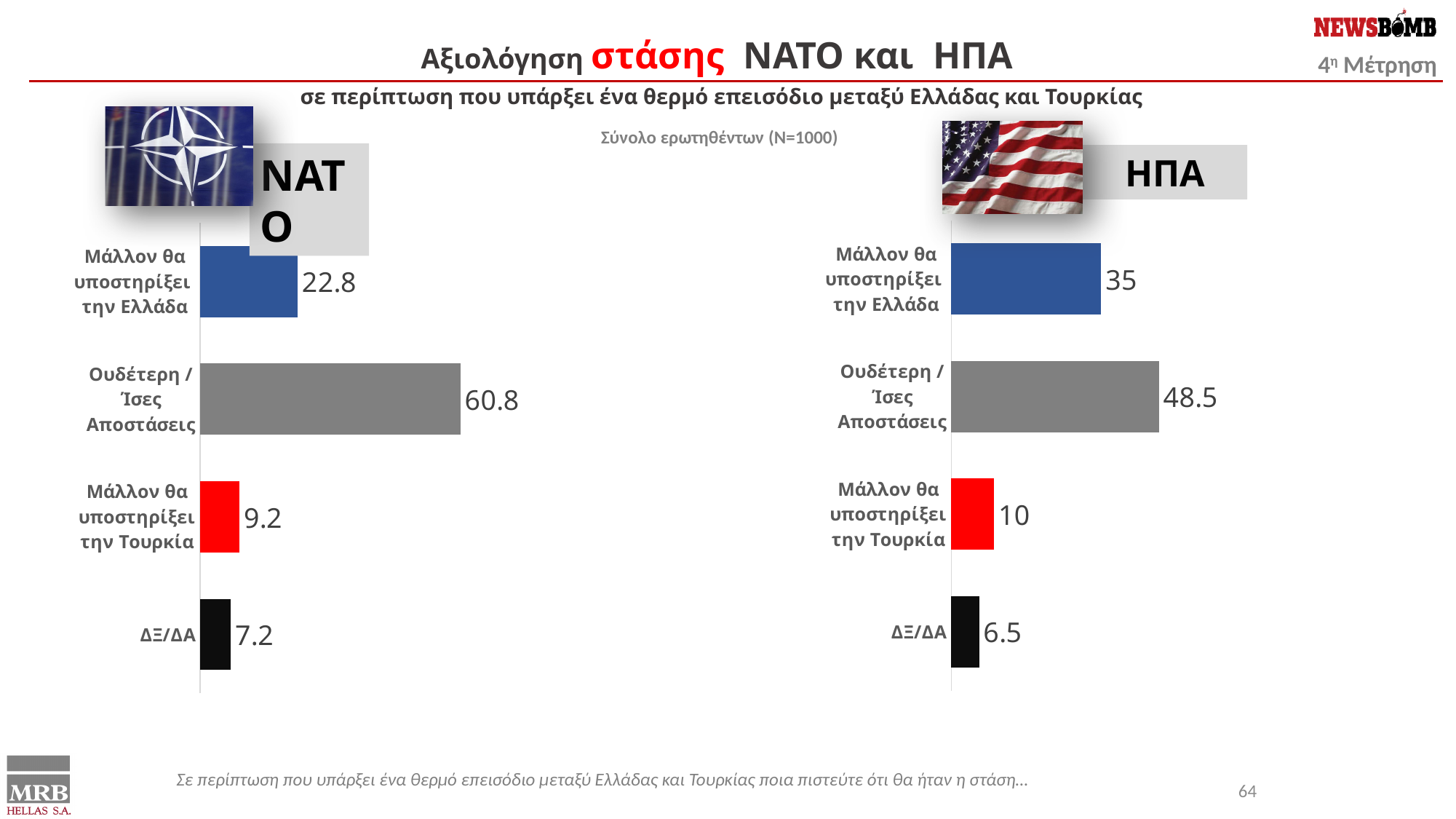
In the NATO chart, what is the value for 'Μάλλον θα υποστηρίξει την Ελλάδα'? 22.8 Which chart has the larger value for 'Μάλλον θα υποστηρίξει την Ελλάδα', NATO or ΗΠΑ? ΗΠΑ In the NATO chart, what is the difference between 'Μάλλον θα υποστηρίξει την Ελλάδα' and 'Μάλλον θα υποστηρίξει την Τουρκία'? 13.6 What is the sample size (N) stated on the slide? N=1000 What is the difference between the 'Ουδέτερη / Ίσες Αποστάσεις' values in the NATO chart and the ΗΠΑ chart? 12.3 In the ΗΠΑ chart, which category has the lowest value? ΔΞ/ΔΑ What type of chart is the NATO chart? Bar chart In the NATO chart, which category has the highest value? Ουδέτερη / Ίσες Αποστάσεις In the NATO chart, what is the value for 'ΔΞ/ΔΑ'? 7.2 In the ΗΠΑ chart, what is the value for 'Μάλλον θα υποστηρίξει την Τουρκία'? 10 How many categories are shown in the ΗΠΑ chart? 4 In the ΗΠΑ chart, what is the value for 'Ουδέτερη / Ίσες Αποστάσεις'? 48.5